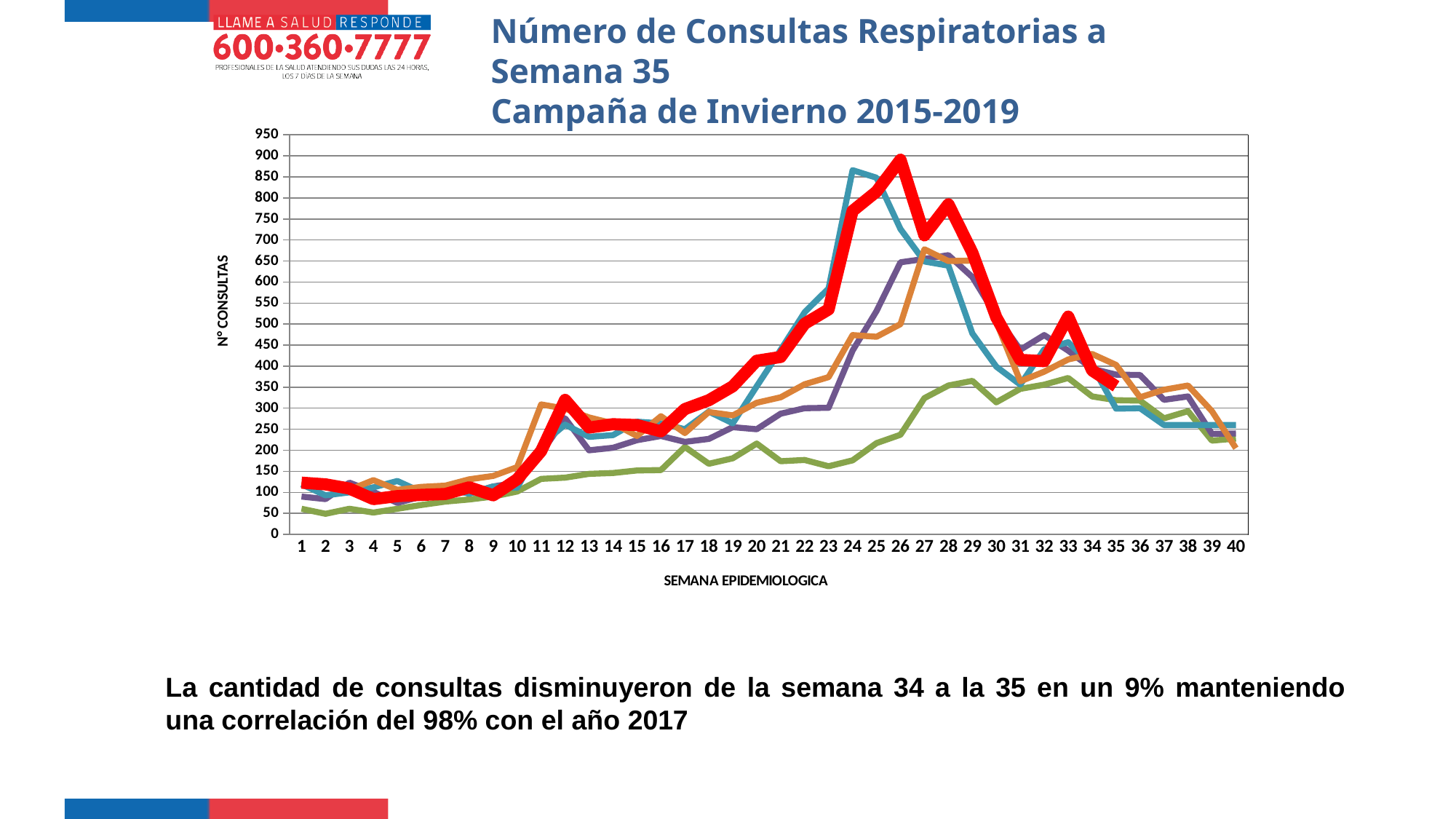
How many epidemiological weeks are shown on the x axis of the chart? 40 What kind of chart is shown on the slide? line chart What is the title of the y axis of the chart? N° CONSULTAS How many lines are plotted on the chart? 5 Is the value of the green line at week 29 greater or less than 400? less Which line reaches the highest value anywhere on the chart? the thick red line Is the value of the orange line at week 11 greater or less than 250? greater Is the value of the thick red line at week 4 greater or less than 100? less What is the title of the x axis of the chart? SEMANA EPIDEMIOLOGICA Does the thick red line rise or fall between week 26 and week 31? fall